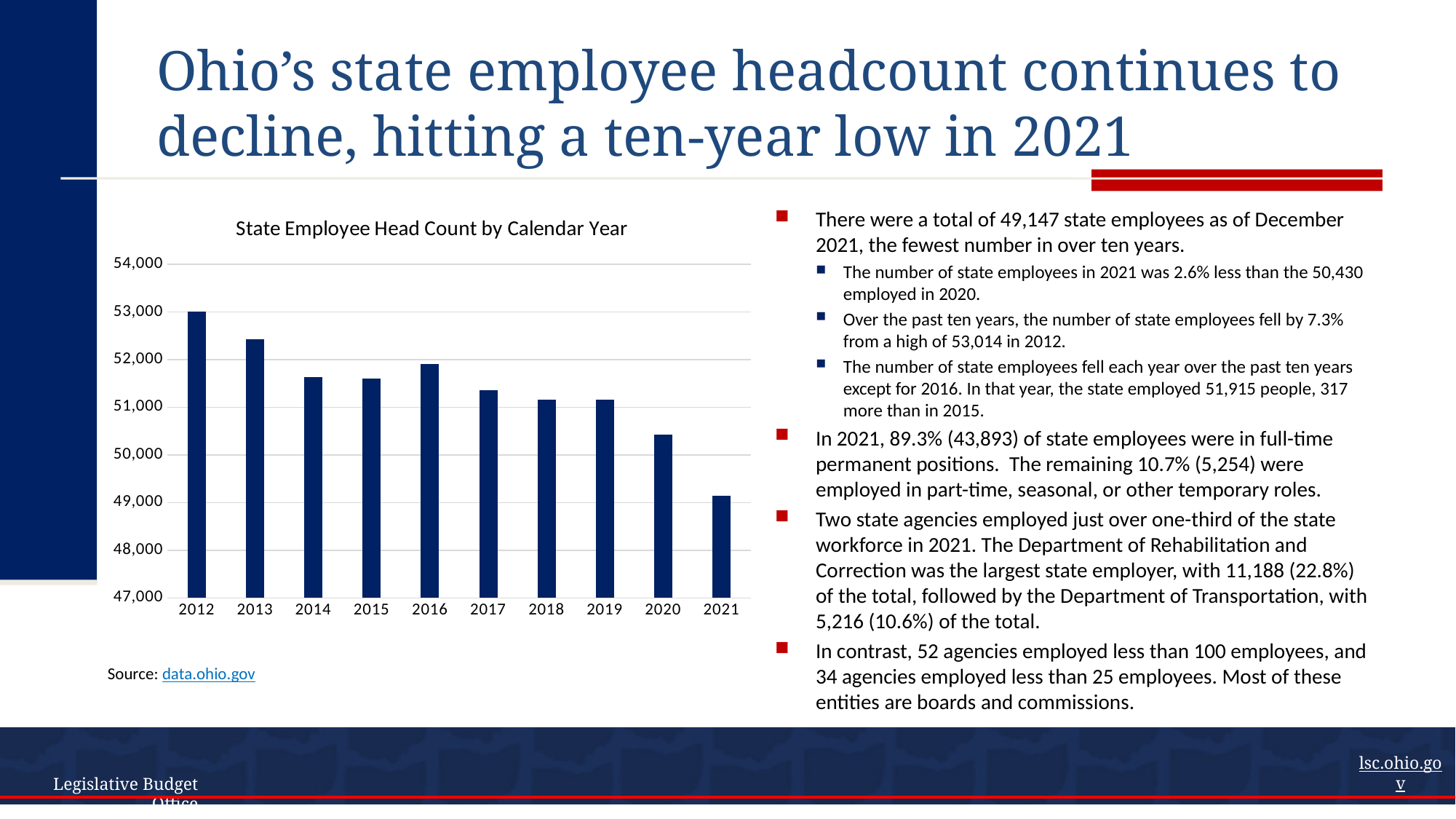
What kind of chart is shown on the slide? bar chart Is the head count for 2020 greater or less than 51,000? less Which year has the larger head count, 2015 or 2016? 2016 Is the head count for 2017 greater or less than 51,000? greater Which year has the highest state employee head count in the chart? 2012 Which year has the larger head count, 2013 or 2014? 2013 What is the title of the chart? State Employee Head Count by Calendar Year Overall, do the head count values rise or fall from 2012 to 2021? fall How many calendar years are shown on the x axis of the chart? 10 Which year has the lowest state employee head count in the chart? 2021 Is the head count for 2021 greater or less than 50,000? less